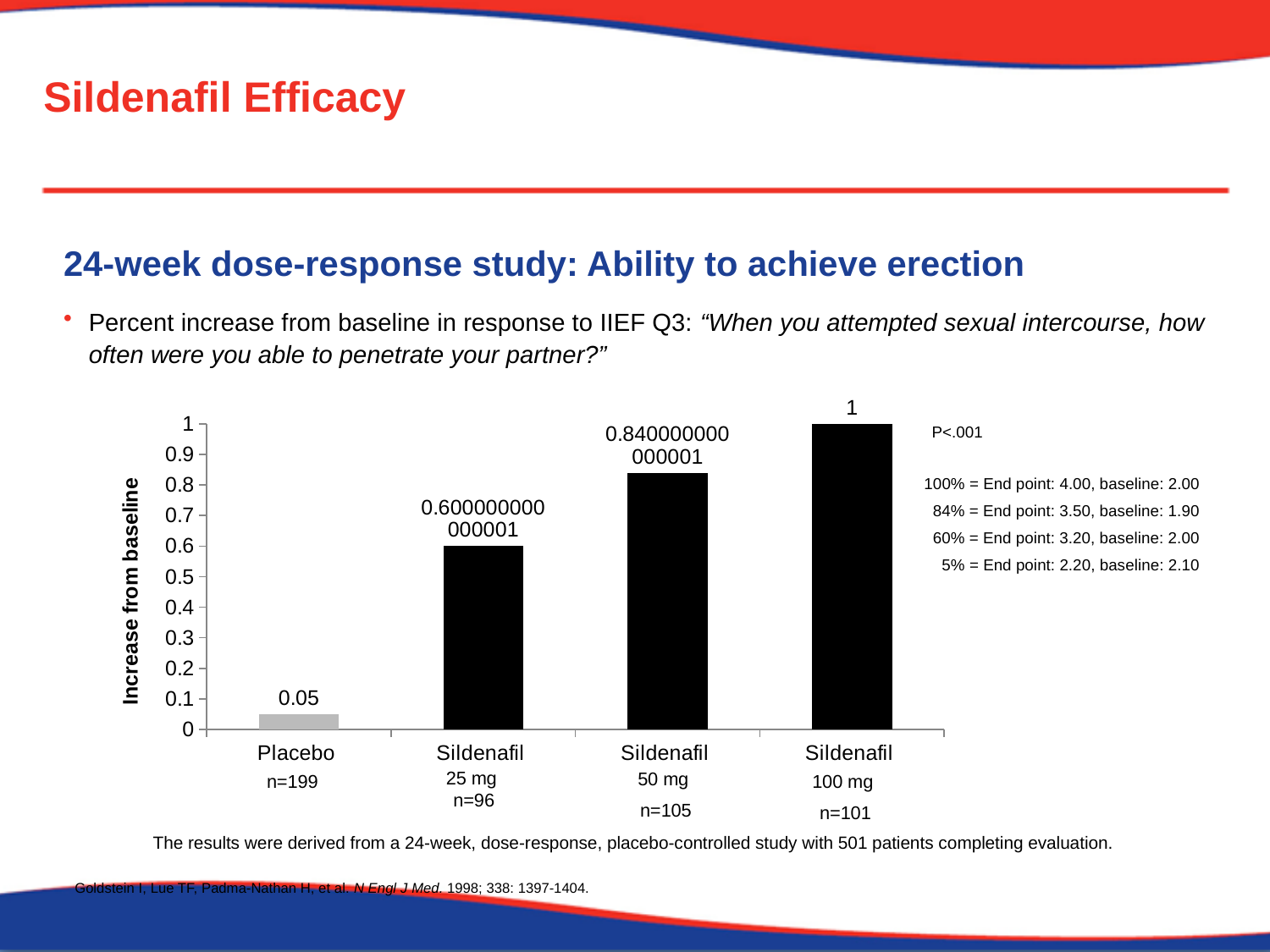
What is the difference between the values for Sildenafil 100 mg and Placebo? 0.95 What is the value shown for Placebo? 0.05 How many categories (bars) are plotted in the chart? 4 Is the value for Sildenafil 25 mg greater or less than 0.5? greater Which is larger, the value for Sildenafil 50 mg or Sildenafil 25 mg? Sildenafil 50 mg What kind of chart is shown on the slide? bar chart What is the value shown for Sildenafil 100 mg? 1 Do the values rise or fall moving from Placebo to Sildenafil 100 mg along the x axis? rise Is the value for Sildenafil 50 mg greater or less than 0.9? less What is the title of the vertical axis of the chart? Increase from baseline Which category has the lowest value in the chart? Placebo Which category has the highest value in the chart? Sildenafil 100 mg